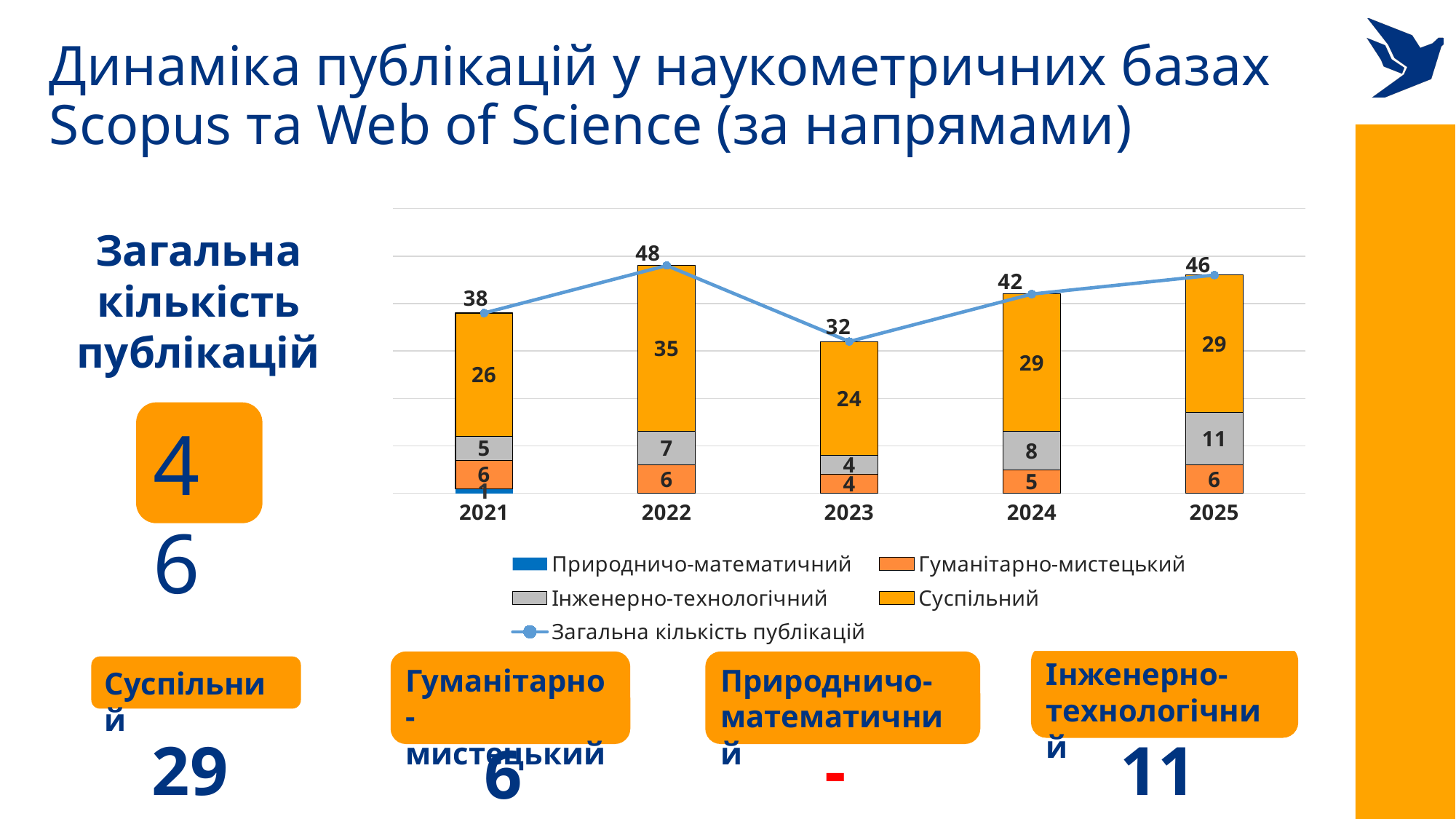
Which year has the highest total number of publications? 2022 Which year has the lowest total number of publications? 2023 How many series does the chart legend list? 5 What is the value of the Гуманітарно-мистецький segment for 2024? 5 What is the difference between the total publications in 2022 and 2023? 16 How many years are shown on the x axis of the chart? 5 Does the total number of publications rise or fall from 2023 to 2025? Rise What is the value of the Суспільний segment for 2023? 24 Which is larger: the Інженерно-технологічний value in 2024 or in 2025? 2025 What is the total number of publications (Загальна кількість публікацій) shown for 2022? 48 What kind of chart is shown on the slide? Stacked bar chart with a line What is the value of the Інженерно-технологічний segment for 2025? 11